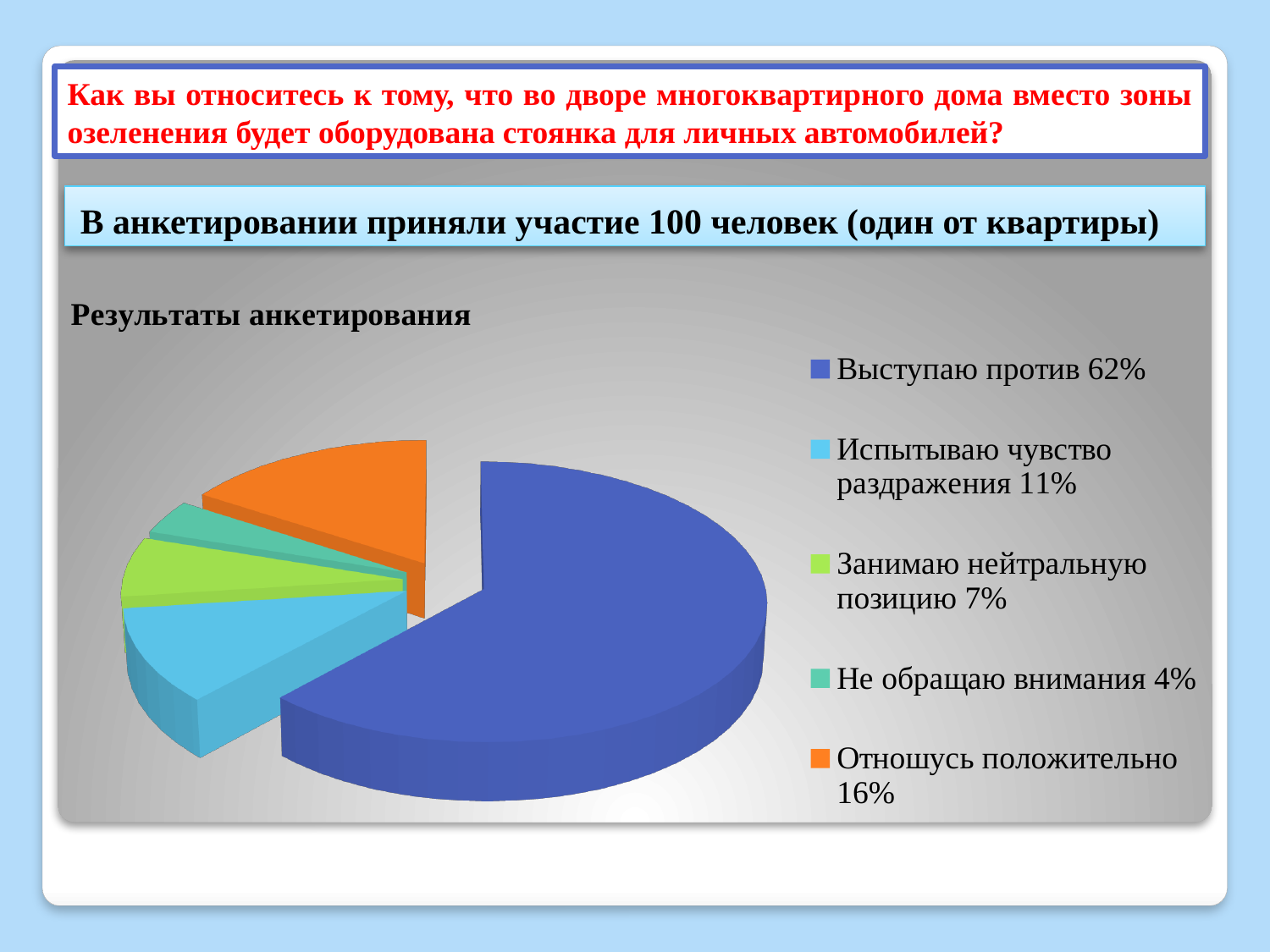
Which response has the smallest share of the pie? Не обращаю внимания What share of respondents chose "Испытываю чувство раздражения"? 11% Which is larger: the share for "Испытываю чувство раздражения" or for "Отношусь положительно"? Отношусь положительно What kind of chart is shown under "Результаты анкетирования"? pie chart What is the difference in percentage points between "Выступаю против" and "Отношусь положительно"? 46 What share of respondents chose "Выступаю против"? 62% What share of respondents chose "Отношусь положительно"? 16% Which response has the largest share of the pie? Выступаю против What share of respondents chose "Не обращаю внимания"? 4% What share of respondents chose "Занимаю нейтральную позицию"? 7% How many categories does the pie chart have? 5 What colour is the slice for "Отношусь положительно"? orange